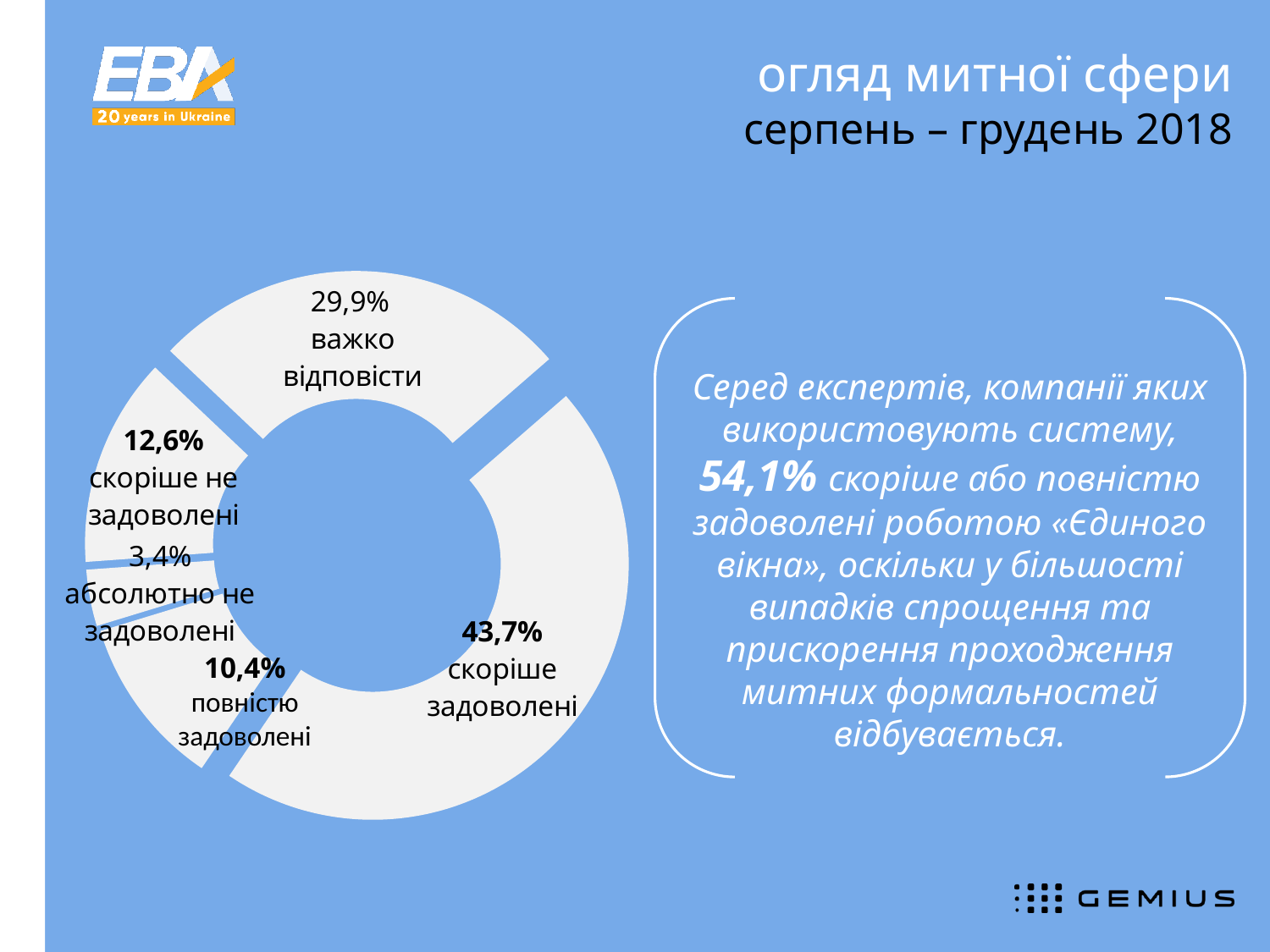
Which response category has the smallest share in the chart? абсолютно не задоволені What share of respondents answered "скоріше не задоволені"? 12,6% What share of respondents answered "скоріше задоволені"? 43,7% How many response categories are shown in the chart? 5 What is the difference in percentage points between "скоріше задоволені" and "важко відповісти"? 13,8 What share of respondents answered "важко відповісти"? 29,9% What is the combined share of "скоріше задоволені" and "повністю задоволені"? 54,1% Which is larger: the share for "скоріше не задоволені" or the share for "повністю задоволені"? скоріше не задоволені Which response category has the largest share in the chart? скоріше задоволені What share of respondents answered "абсолютно не задоволені"? 3,4% What kind of chart is shown on the slide? Doughnut (pie) chart What share of respondents answered "повністю задоволені"? 10,4%